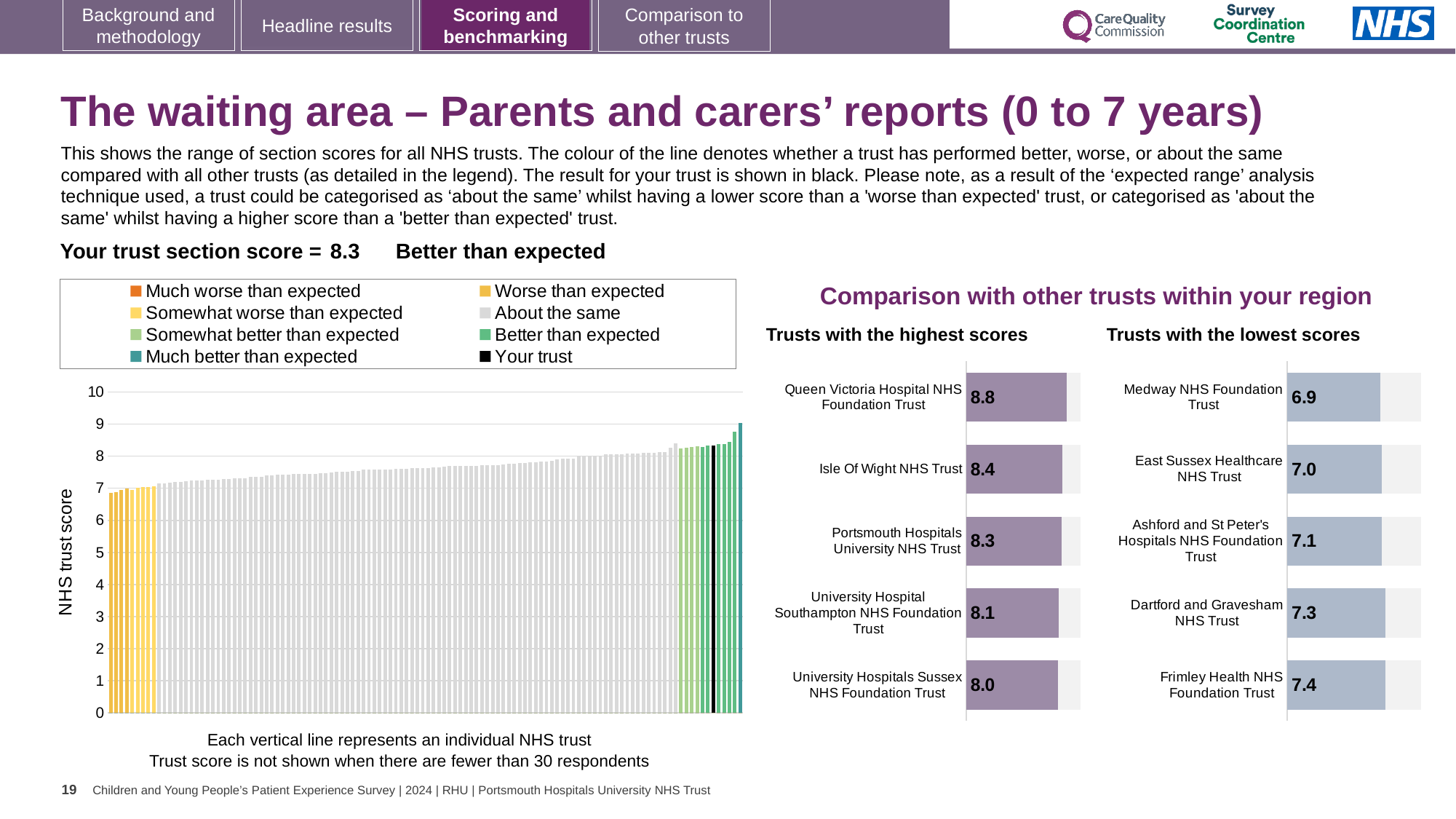
What kind of chart is the 'NHS trust score' chart on the left of the slide? Bar chart In the 'Trusts with the highest scores' chart, what is the difference between the scores of Queen Victoria Hospital NHS Foundation Trust and University Hospitals Sussex NHS Foundation Trust? 0.8 In the 'Trusts with the highest scores' chart, which trust has the highest score? Queen Victoria Hospital NHS Foundation Trust How many entries does the legend above the 'NHS trust score' chart list? 8 In the 'Trusts with the highest scores' chart, what is the score for Queen Victoria Hospital NHS Foundation Trust? 8.8 In the 'Trusts with the lowest scores' chart, which trust has the lowest score? Medway NHS Foundation Trust How many trusts are shown in the 'Trusts with the lowest scores' chart? 5 In the 'Trusts with the lowest scores' chart, what is the difference between the scores of Frimley Health NHS Foundation Trust and Medway NHS Foundation Trust? 0.5 In the 'NHS trust score' chart on the left, do the bar values rise or fall from left to right? Rise In the 'Trusts with the lowest scores' chart, what is the score for Medway NHS Foundation Trust? 6.9 How many trusts are shown in the 'Trusts with the highest scores' chart? 5 In the 'Trusts with the lowest scores' chart, which has the larger score: Dartford and Gravesham NHS Trust or Frimley Health NHS Foundation Trust? Frimley Health NHS Foundation Trust